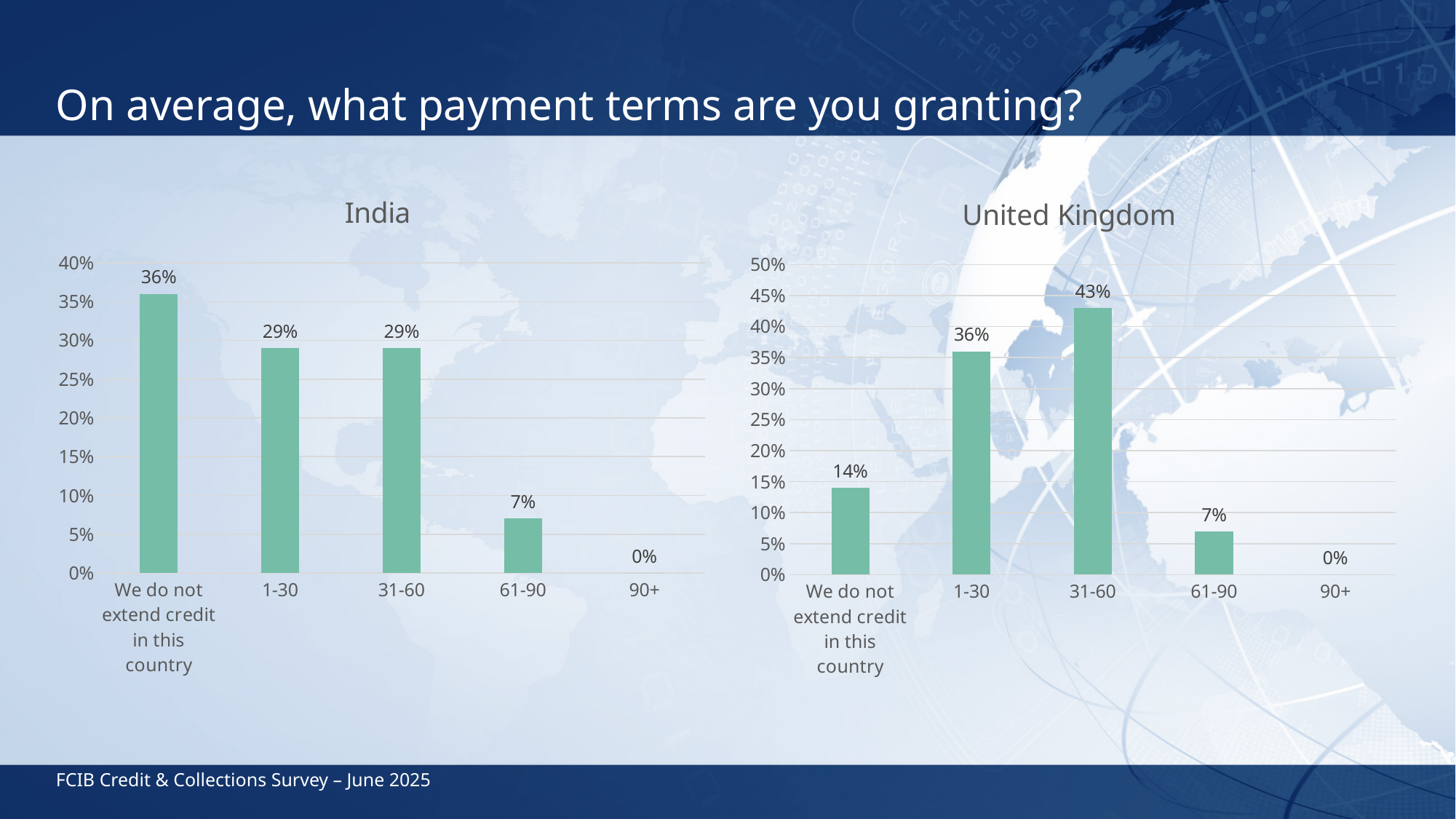
What is the title of the chart on the right side of the slide? United Kingdom In the United Kingdom chart, what is the value for 31-60? 43% In the India chart, which category has the lowest value? 90+ How many categories are shown on the x axis of the United Kingdom chart? 5 In the India chart, what is the value for 'We do not extend credit in this country'? 36% What type of chart is the India chart? Bar chart In the United Kingdom chart, what is the difference between the values for 31-60 and 1-30? 7% In the India chart, which category has the highest value? We do not extend credit in this country In the United Kingdom chart, which category has the highest value? 31-60 In the India chart, which is larger: the value for 1-30 or the value for 61-90? 1-30 In the United Kingdom chart, what is the value for 'We do not extend credit in this country'? 14% In the India chart, what is the difference between the values for 'We do not extend credit in this country' and 61-90? 29%